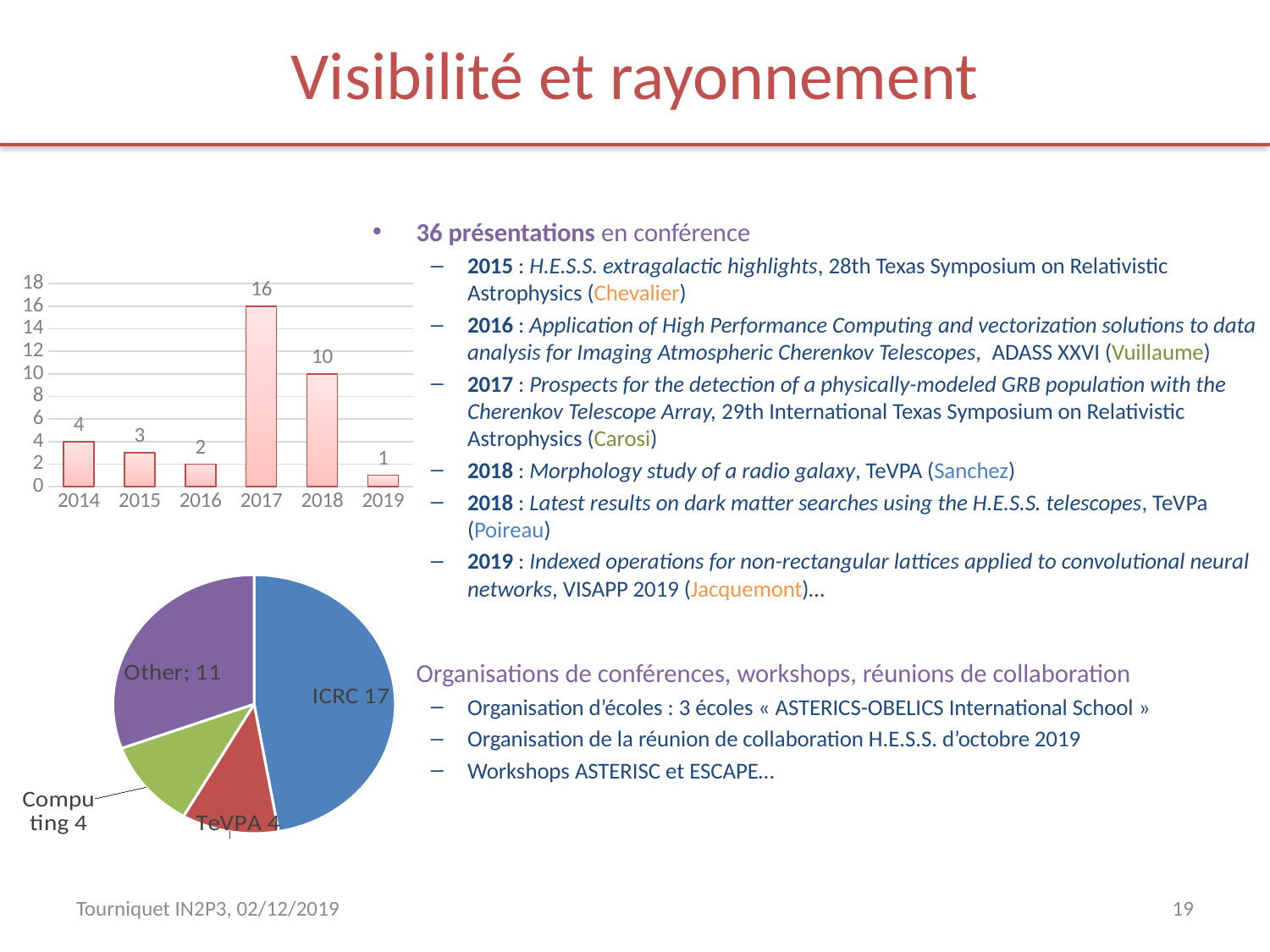
In the bar chart at the top left, what is the difference between the values for 2017 and 2018? 6 What kind of chart is the chart at the top left of the slide? bar chart What kind of chart is the chart at the bottom left of the slide? pie chart In the pie chart at the bottom left, what is the value for Other? 11 In the bar chart at the top left, what is the value for 2018? 10 In the bar chart at the top left, which year has the lowest value? 2019 How many years are shown on the x axis of the bar chart at the top left? 6 In the bar chart at the top left, which is larger, the value for 2014 or the value for 2015? 2014 In the bar chart at the top left, which year has the highest value? 2017 In the pie chart at the bottom left, which slice is the largest? ICRC In the pie chart at the bottom left, what is the value for ICRC? 17 In the bar chart at the top left, what is the value for 2017? 16